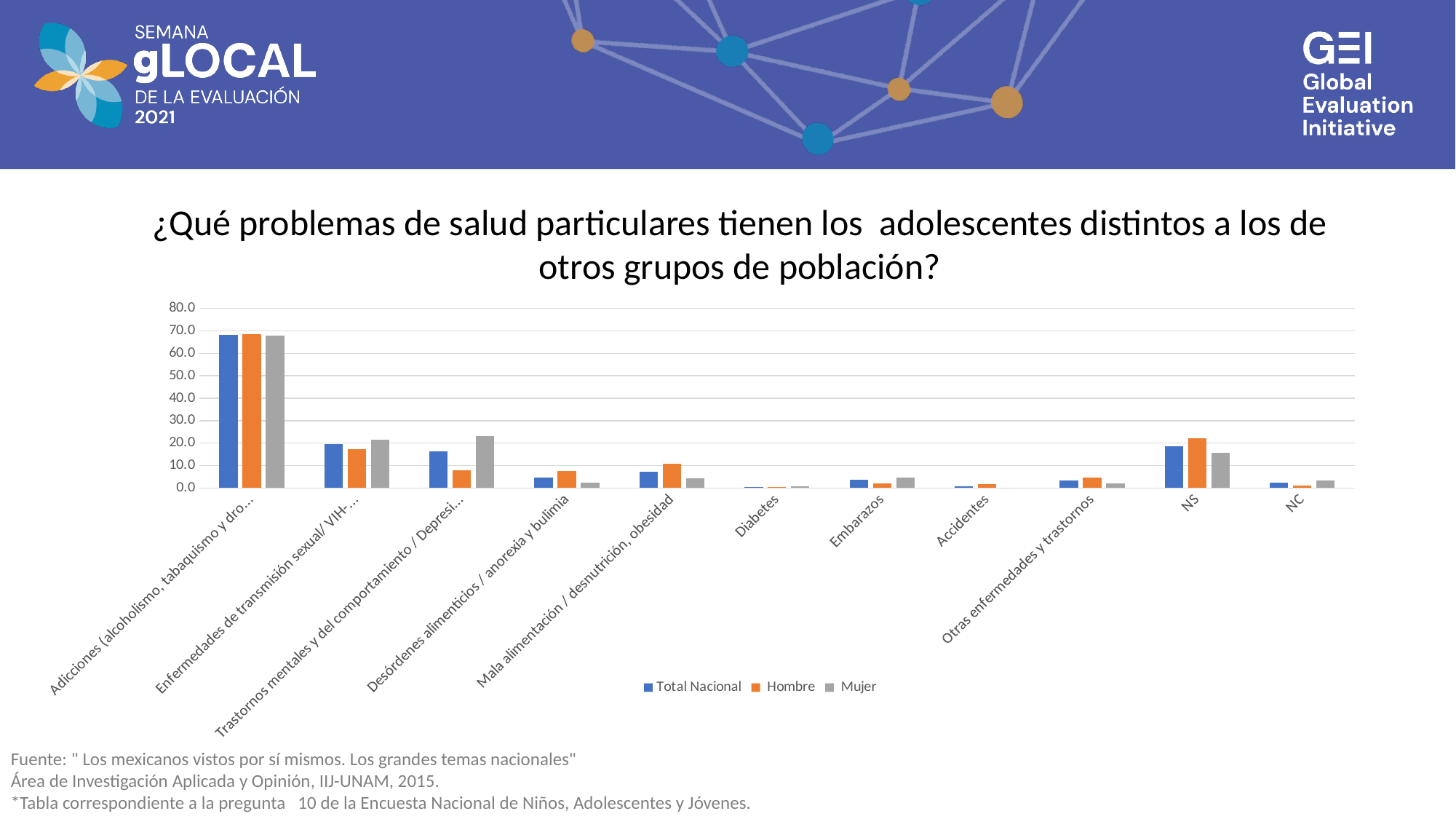
What kind of chart is shown on the slide? Bar chart How many series does the legend list? 3 Which category has the highest value for Total Nacional? Adicciones (alcoholismo, tabaquismo y dro...) Is the Mujer value for Trastornos mentales y del comportamiento / Depresi... greater or less than 20? greater How many categories are shown on the x axis? 11 What are the three series listed in the legend? Total Nacional, Hombre, Mujer For Trastornos mentales y del comportamiento / Depresi..., which is larger: Hombre or Mujer? Mujer Is the Total Nacional value for Diabetes greater or less than 10? less For Mala alimentación / desnutrición, obesidad, which is larger: Hombre or Mujer? Hombre Is the Total Nacional value for Adicciones greater or less than 60? greater For NS, which is larger: Hombre or Mujer? Hombre